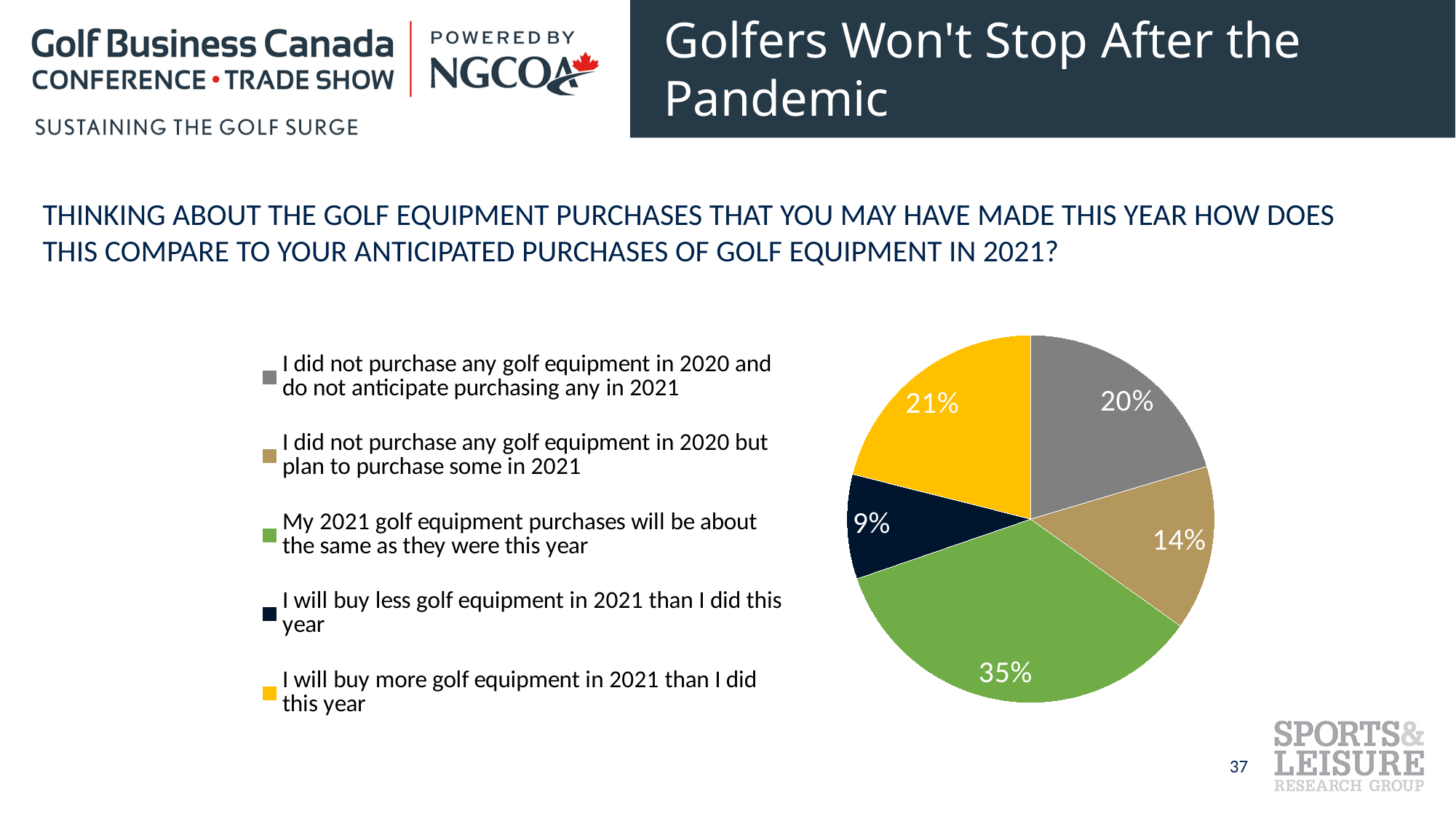
What share of respondents said they will buy less golf equipment in 2021 than this year? 9% Which is larger: the share who will buy more golf equipment in 2021 or the share who did not purchase any in 2020 but plan to in 2021? I will buy more golf equipment in 2021 than I did this year What is the difference in percentage points between those who will buy more golf equipment in 2021 and those who will buy less? 12 Which response has the largest slice of the pie? My 2021 golf equipment purchases will be about the same as they were this year What colour is the slice for respondents who will buy less golf equipment in 2021 than this year? dark navy Which response has the smallest slice of the pie? I will buy less golf equipment in 2021 than I did this year What share of respondents did not purchase any golf equipment in 2020 and do not anticipate purchasing any in 2021? 20% What share of respondents did not purchase any golf equipment in 2020 but plan to purchase some in 2021? 14% What kind of chart is shown on the slide? pie chart How many response categories does the pie chart show? 5 What share of respondents said their 2021 golf equipment purchases will be about the same as this year? 35% What share of respondents said they will buy more golf equipment in 2021 than they did this year? 21%